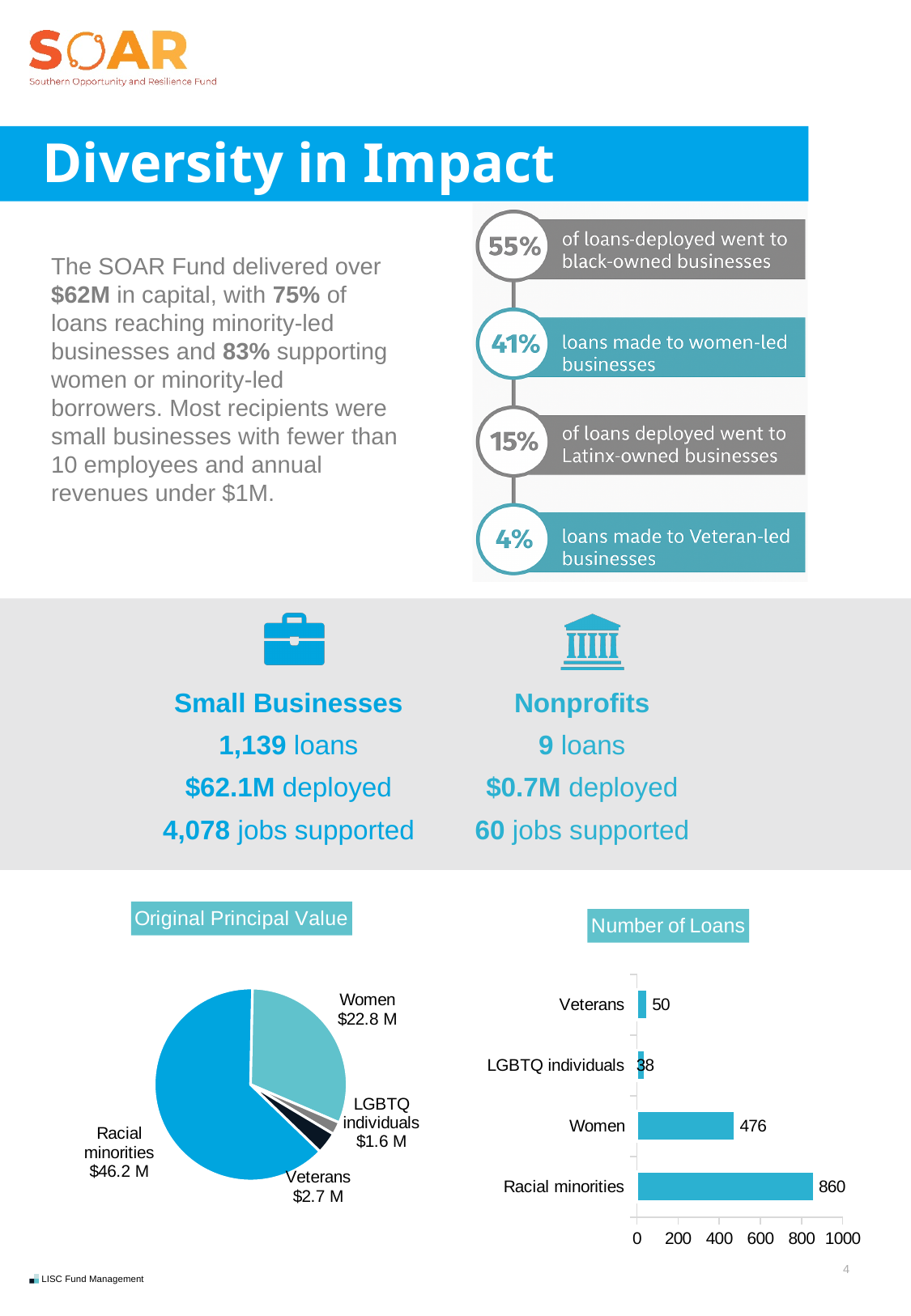
In the Number of Loans chart, how many categories are shown? 4 What kind of chart is the Original Principal Value chart? Pie chart In the Number of Loans chart, is the value for Racial minorities greater or less than 800? greater What kind of chart is the Number of Loans chart? Bar chart In the Original Principal Value chart, what is the value for LGBTQ individuals? $1.6 M In the Number of Loans chart, how many loans went to Veterans? 50 In the Number of Loans chart, what is the difference between the number of loans to Racial minorities and to Women? 384 In the Number of Loans chart, which category has the highest number of loans? Racial minorities In the Number of Loans chart, how many loans went to Women? 476 In the Number of Loans chart, which category has the lowest number of loans? LGBTQ individuals In the Original Principal Value chart, what is the value for Racial minorities? $46.2 M In the Original Principal Value chart, which is larger, the value for Veterans or the value for LGBTQ individuals? Veterans